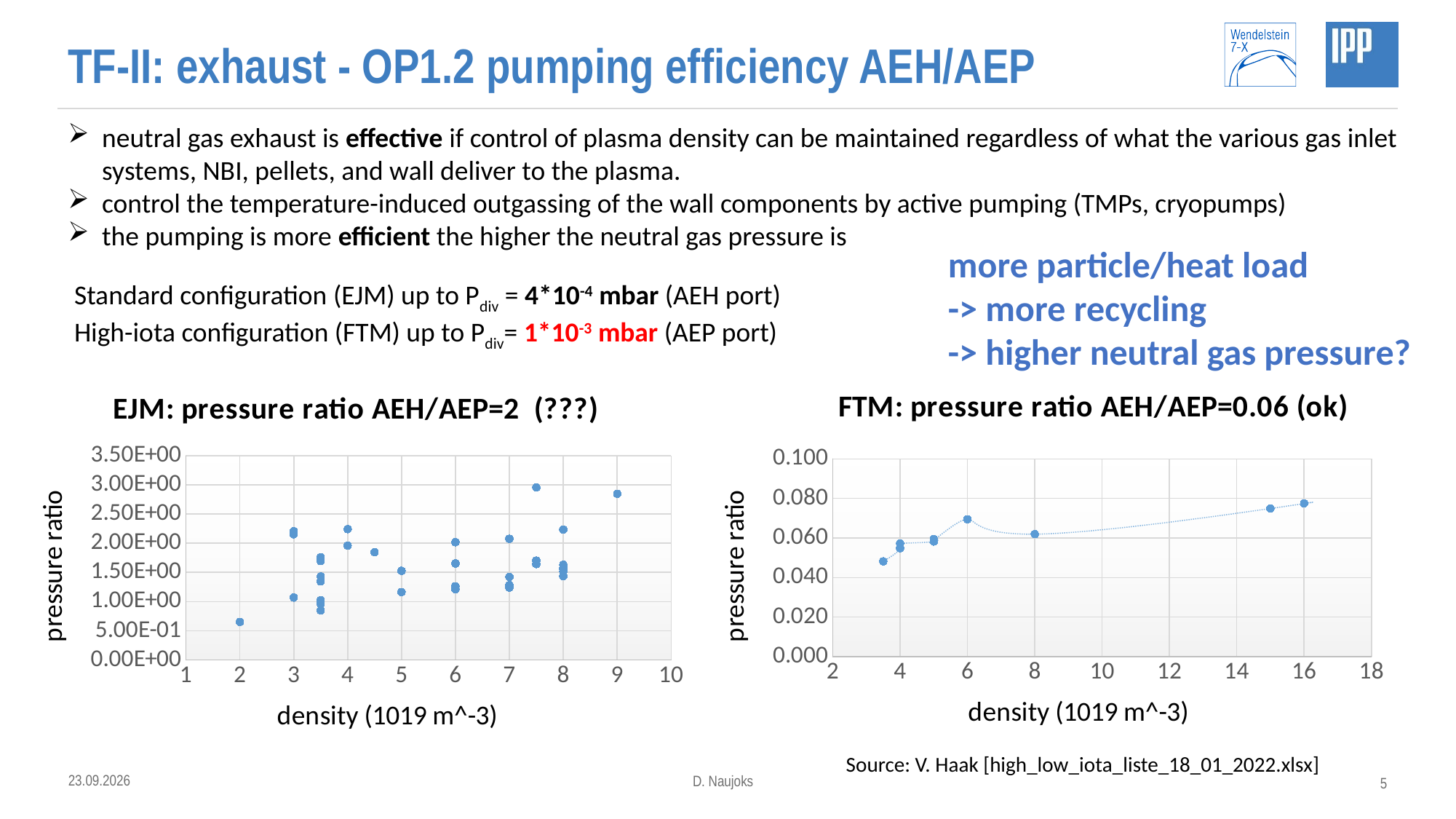
In the EJM chart on the left, at which density does the lowest pressure ratio occur? 2 In the FTM chart on the right, is the pressure ratio for the point at density 6 greater or less than 0.060? greater In the FTM chart on the right, do the pressure ratio values generally rise or fall as density increases? rise What is the highest value shown on the y-axis of the FTM chart on the right? 0.100 What is the x-axis label of the EJM chart on the left? density (1019 m^-3) What kind of chart is the chart titled "FTM: pressure ratio AEH/AEP=0.06 (ok)"? scatter chart In the EJM chart on the left, is the pressure ratio for the point at density 2 greater or less than 1.00E+00? less In the FTM chart on the right, which point has the larger pressure ratio: the one at density 6 or the one at density 8? density 6 In the EJM chart on the left, is the pressure ratio for the point at density 9 greater or less than 2.50E+00? greater What kind of chart is the chart titled "EJM: pressure ratio AEH/AEP=2 (???)"? scatter chart